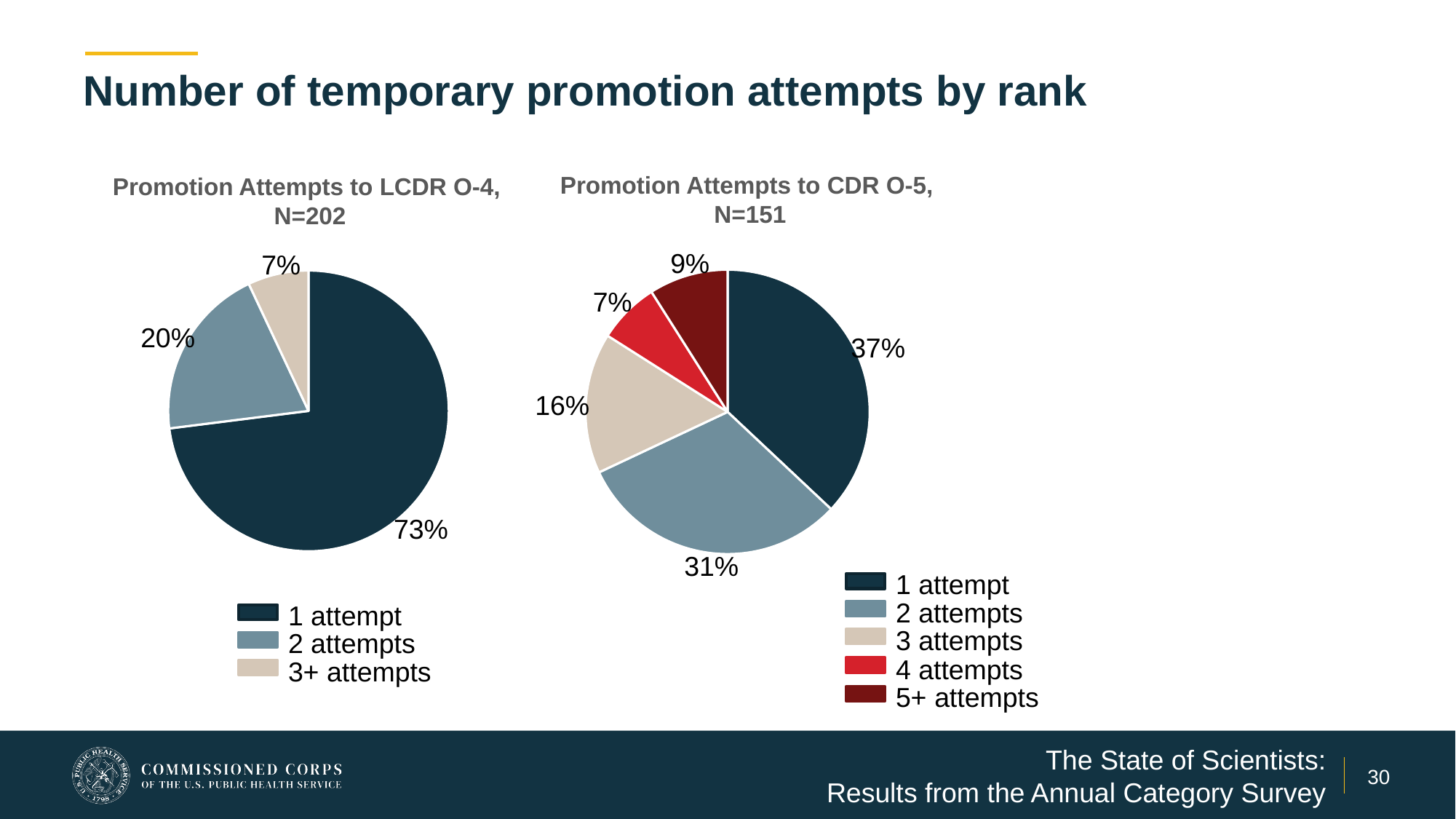
In the 'Promotion Attempts to LCDR O-4, N=202' chart, what is the value for '2 attempts'? 20% In the 'Promotion Attempts to CDR O-5, N=151' chart, what is the value for '3 attempts'? 16% In the 'Promotion Attempts to CDR O-5, N=151' chart, which category has the smallest slice? 4 attempts In the 'Promotion Attempts to LCDR O-4, N=202' chart, what is the value for '3+ attempts'? 7% In the 'Promotion Attempts to LCDR O-4, N=202' chart, what share of the pie is '1 attempt'? 73% How many categories does the legend of the 'Promotion Attempts to CDR O-5, N=151' chart list? 5 What type of chart is used for 'Promotion Attempts to LCDR O-4, N=202'? Pie chart In the 'Promotion Attempts to CDR O-5, N=151' chart, what is the difference between the '1 attempt' and '2 attempts' values? 6% In the 'Promotion Attempts to CDR O-5, N=151' chart, what is the value for '5+ attempts'? 9% In the 'Promotion Attempts to LCDR O-4, N=202' chart, which category has the largest slice? 1 attempt In the 'Promotion Attempts to CDR O-5, N=151' chart, what is the value for '1 attempt'? 37% Which is larger: the '2 attempts' share in the LCDR O-4 chart or the '2 attempts' share in the CDR O-5 chart? CDR O-5 chart